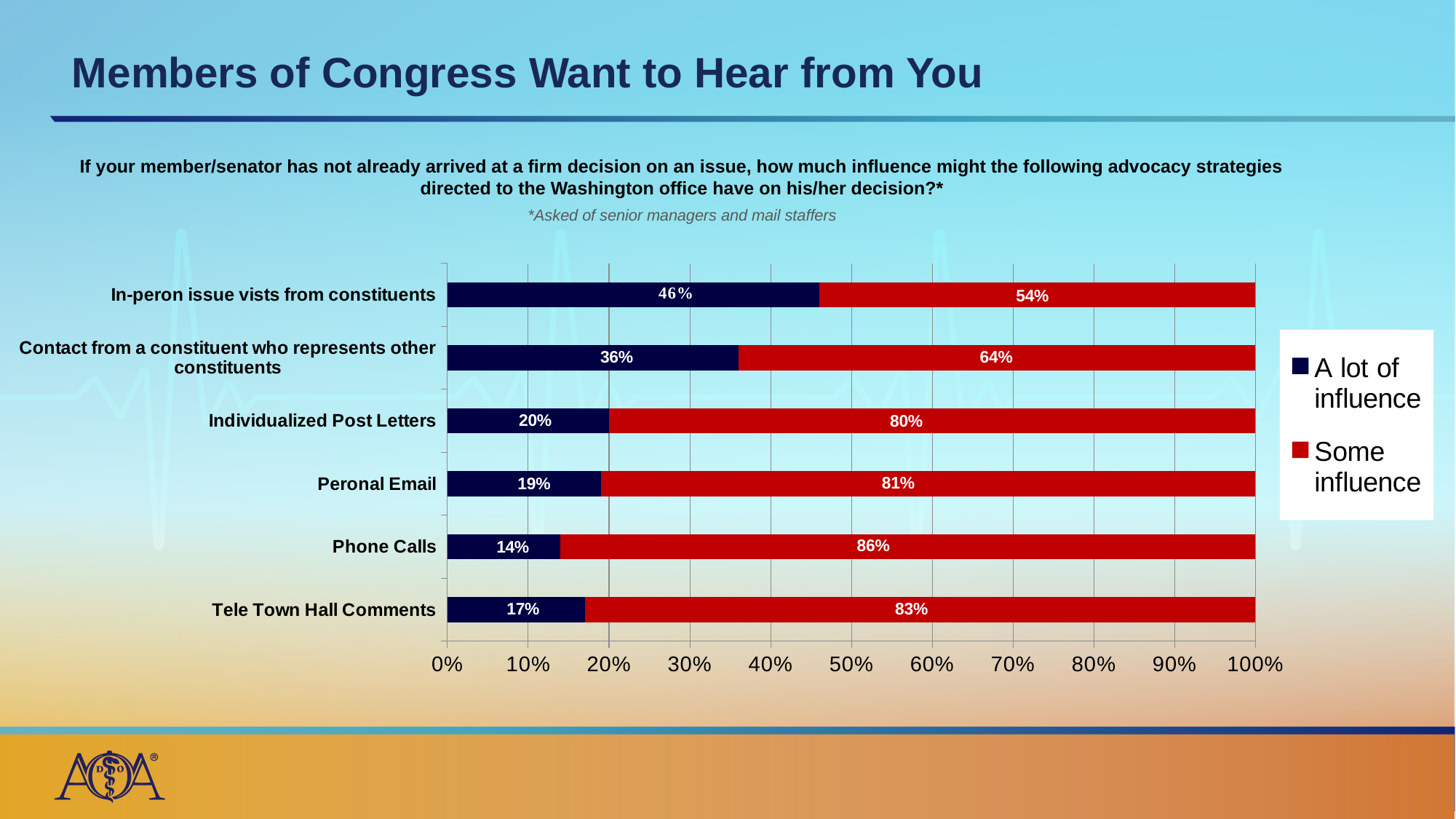
What is the total of the stacked bar for Contact from a constituent who represents other constituents? 100% How many series does the legend list? 2 What percentage of respondents said in-person issue visits from constituents have a lot of influence? 46% Which has a larger 'A lot of influence' value: Personal Email or Tele Town Hall Comments? Peronal Email What is the 'Some influence' value for Individualized Post Letters? 80% What is the difference between the 'A lot of influence' values for in-person issue visits and Individualized Post Letters? 26% What is the 'Some influence' value for Phone Calls? 86% What is the 'A lot of influence' value for Tele Town Hall Comments? 17% What kind of chart is shown on the slide? Stacked bar chart How many advocacy strategies are shown on the chart? 6 Which advocacy strategy has the lowest 'A lot of influence' value? Phone Calls Which advocacy strategy has the highest 'A lot of influence' value? In-peron issue vists from constituents